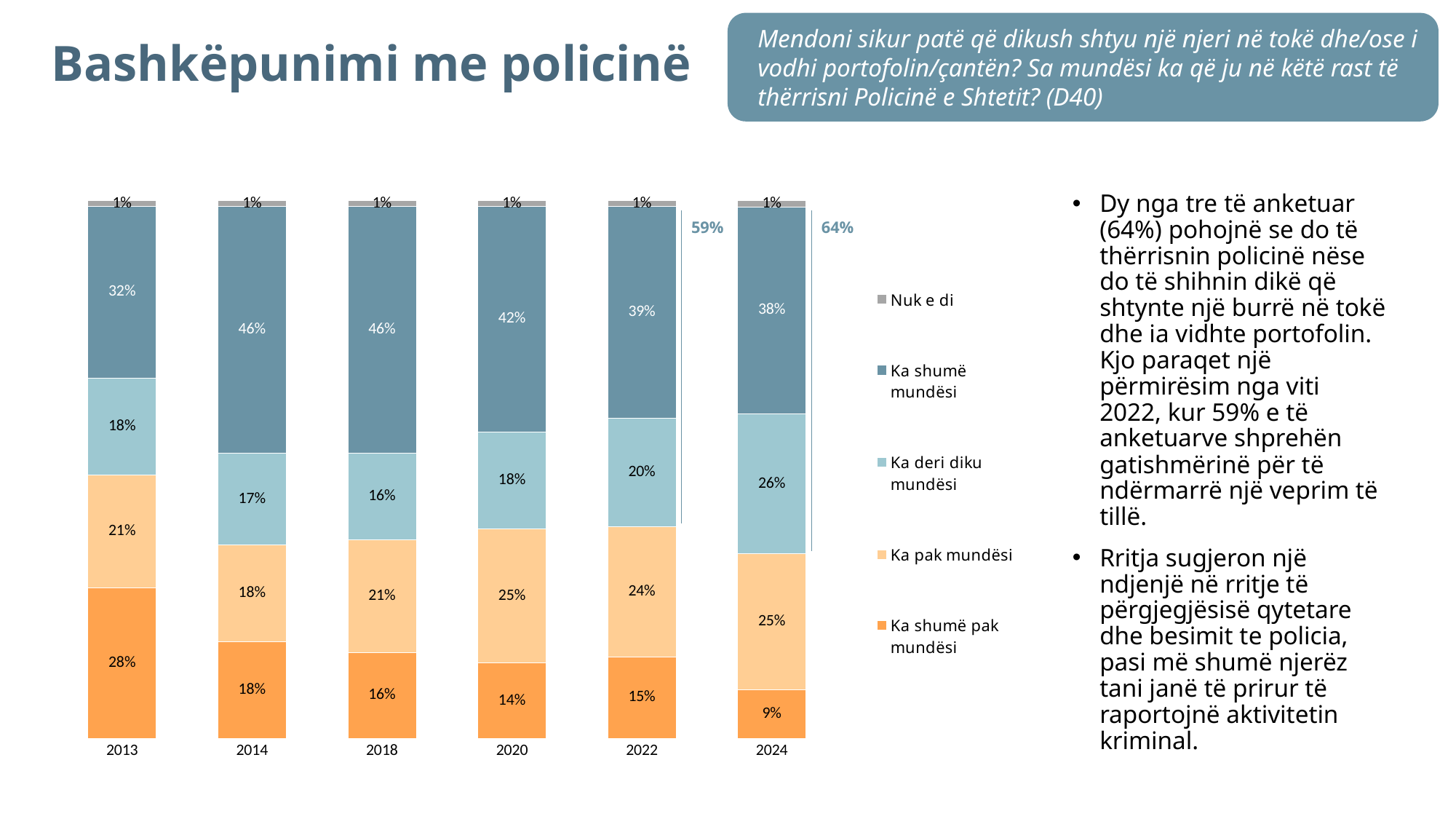
What is the value for "Ka shumë mundësi" in 2013? 32% Does the "Ka shumë pak mundësi" value rise or fall from 2022 to 2024? Fall In which year is the "Ka shumë pak mundësi" value highest? 2013 What is the value for "Ka deri diku mundësi" in 2022? 20% What is the difference between the "Ka shumë mundësi" values in 2014 and 2024? 8% What is the combined value of "Ka shumë mundësi" and "Ka deri diku mundësi" in 2024, as labelled on the chart? 64% Which is larger: "Ka pak mundësi" in 2020 or "Ka pak mundësi" in 2014? 2020 In which year is the "Ka deri diku mundësi" value lowest? 2018 How many series does the legend list? 5 What type of chart is shown on the slide? Stacked bar chart What is the value for "Ka shumë pak mundësi" in 2024? 9% How many years are shown on the x axis of the chart? 6